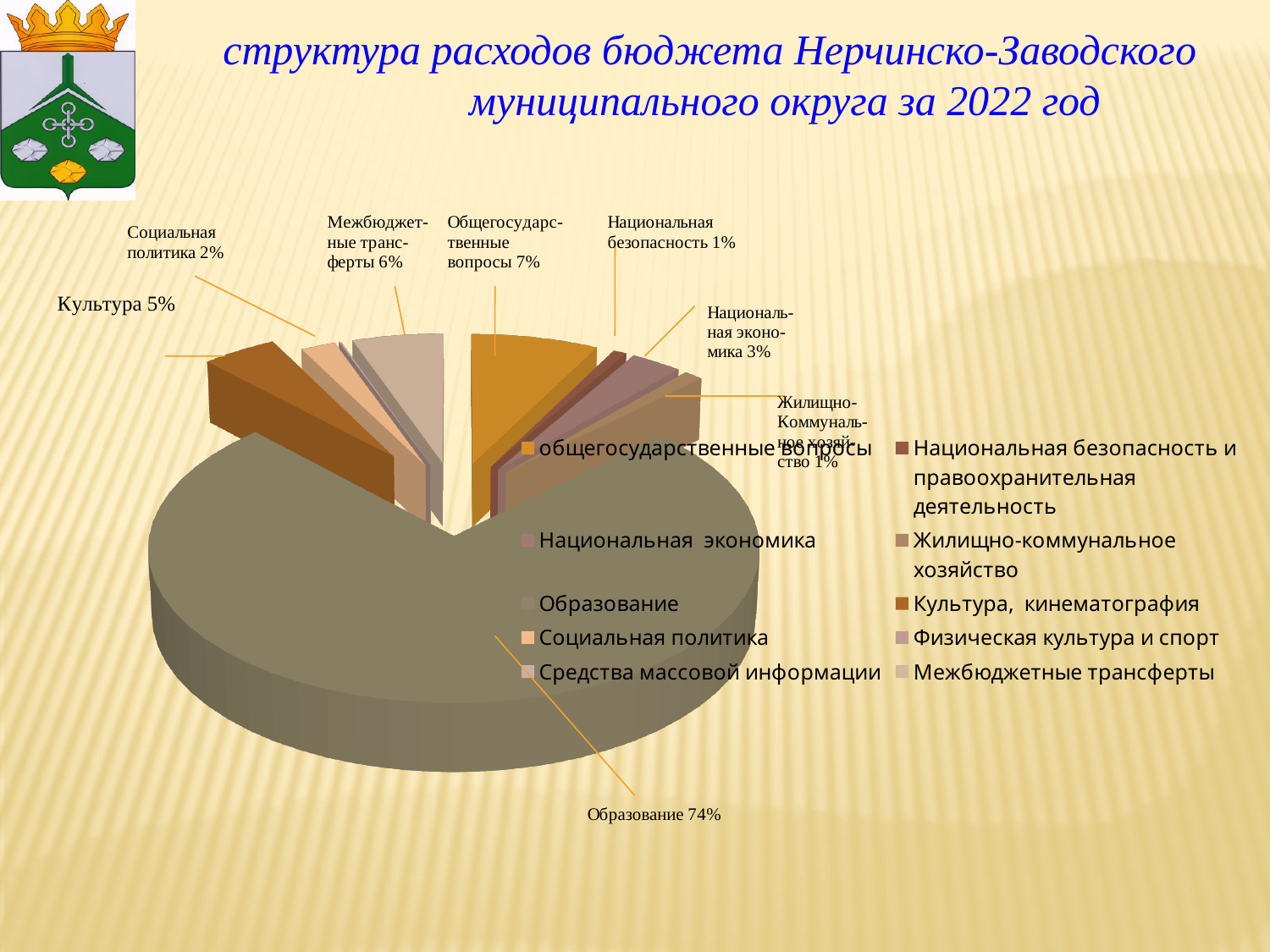
What percentage is shown for Социальная политика? 2% Which year does the chart title say the budget expenditure structure refers to? 2022 What percentage is shown for Национальная экономика? 3% What percentage is shown for Межбюджетные трансферты? 6% What share of the budget expenditure does Образование (education) account for? 74% Which is larger, the share for Межбюджетные трансферты or the share for Культура? Межбюджетные трансферты What is the difference in percentage points between Образование and Общегосударственные вопросы? 67 What kind of chart is shown on the slide? Pie chart What percentage is shown for Культура? 5% How many entries does the legend list? 10 Which category has the largest share of the pie? Образование What percentage is shown for Общегосударственные вопросы? 7%